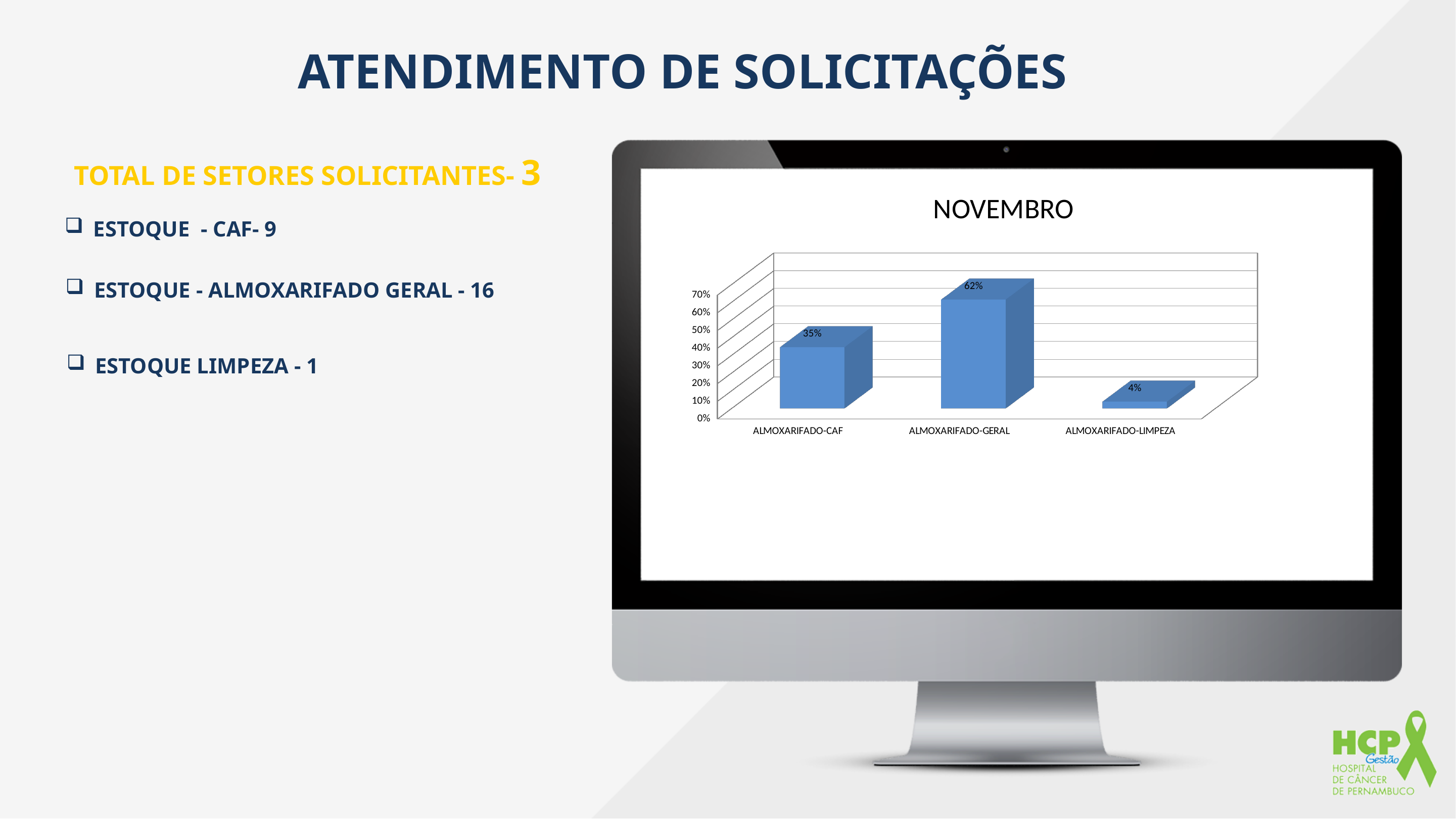
Which is larger, the value for ALMOXARIFADO-CAF or ALMOXARIFADO-LIMPEZA? ALMOXARIFADO-CAF What is the difference between the values for ALMOXARIFADO-CAF and ALMOXARIFADO-LIMPEZA? 31% What kind of chart is shown on the slide? Bar chart What is the difference between the values for ALMOXARIFADO-GERAL and ALMOXARIFADO-CAF? 27% Which category has the lowest value in the NOVEMBRO chart? ALMOXARIFADO-LIMPEZA What is the value for ALMOXARIFADO-LIMPEZA in the NOVEMBRO chart? 4% Which category has the highest value in the NOVEMBRO chart? ALMOXARIFADO-GERAL How many categories are shown in the NOVEMBRO chart? 3 Is the value for ALMOXARIFADO-GERAL greater or less than 50%? greater What is the title of the chart on the slide? NOVEMBRO What is the value for ALMOXARIFADO-GERAL in the NOVEMBRO chart? 62% What is the value for ALMOXARIFADO-CAF in the NOVEMBRO chart? 35%